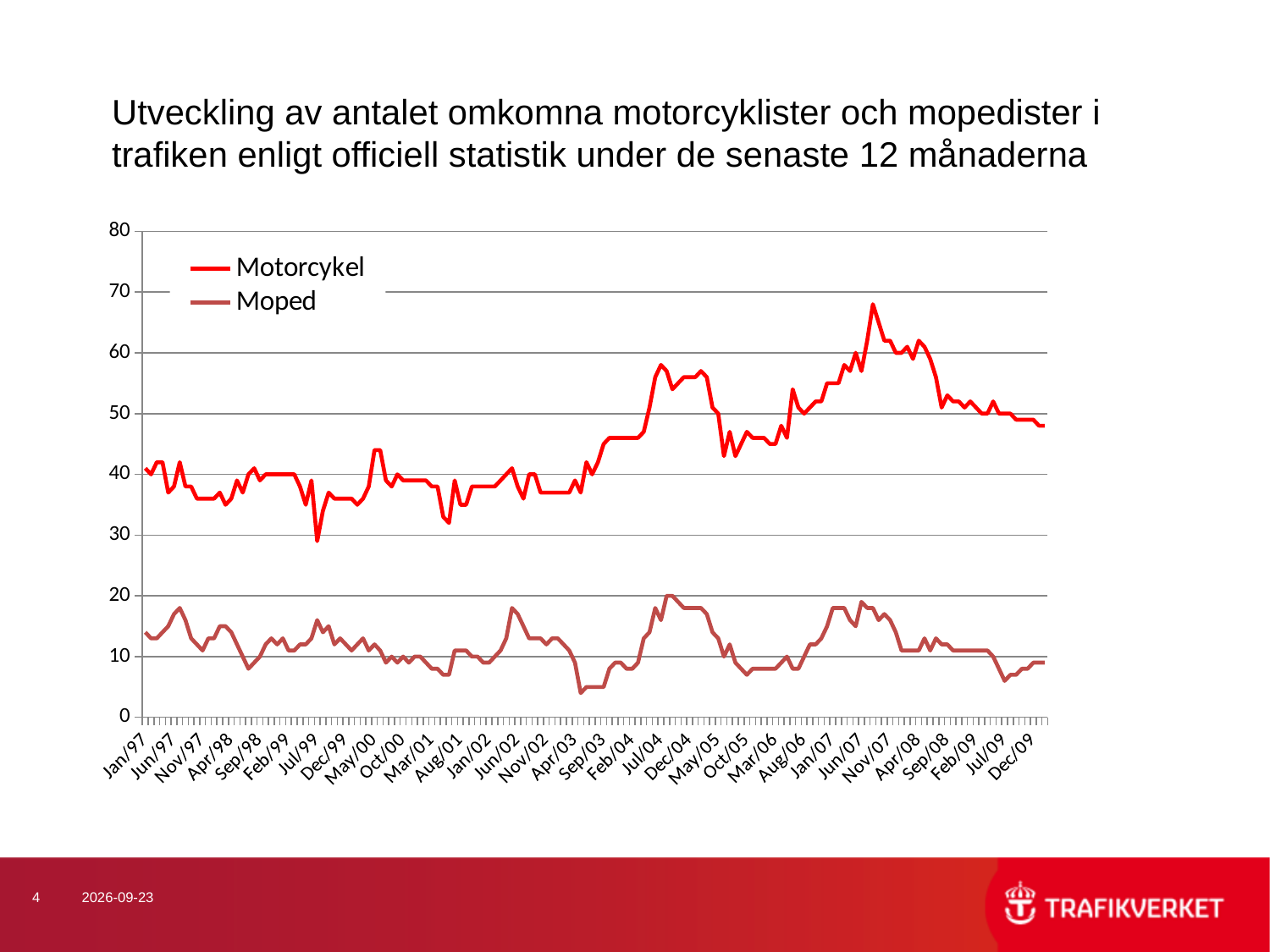
Is the value for Motorcykel at Jul/99 greater or less than 40? less Is the value for Moped around Sep/03 greater or less than 10? less What is the highest value shown on the vertical axis? 80 How many series does the legend list? 2 Which series reaches the highest value on the chart? Motorcykel Is the peak value of the Motorcykel series around Nov/07 greater or less than 60? greater What kind of chart is shown on the slide? line chart What are the two series named in the legend? Motorcykel and Moped Which series has the lowest values on the chart? Moped At Dec/09, which series has the larger value, Motorcykel or Moped? Motorcykel Does the Motorcykel series end higher or lower at Dec/09 than it started at Jan/97? higher